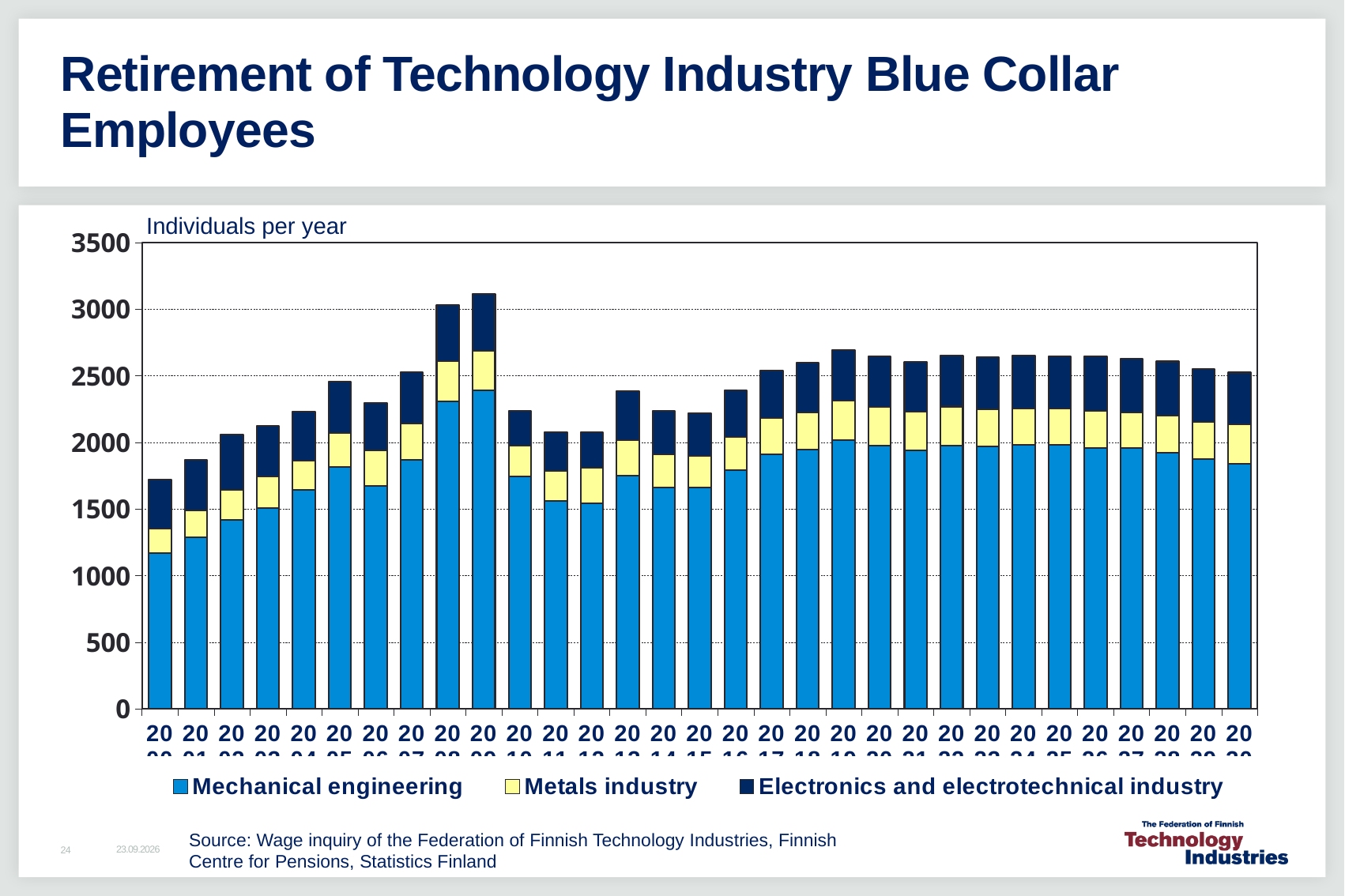
How many bars (years) are plotted in the chart? 31 Is the total of the tallest bar greater or less than 3000? greater Which is larger, the total of the second bar from the left or the total of the third bar from the left? The third bar from the left Which bar has the highest total in the chart? The tenth bar from the left Is the Mechanical engineering segment of the first bar from the left greater or less than 1500? less Is the total of the first bar from the left greater or less than 2000? less What kind of chart is shown on the slide? Stacked bar chart Which series is shown in dark navy blue in the legend? Electronics and electrotechnical industry What unit label is shown above the vertical axis? Individuals per year How many series does the legend list? 3 Do the bar totals rise or fall across the first five bars from the left? rise Which bar has the lowest total in the chart? The first bar from the left